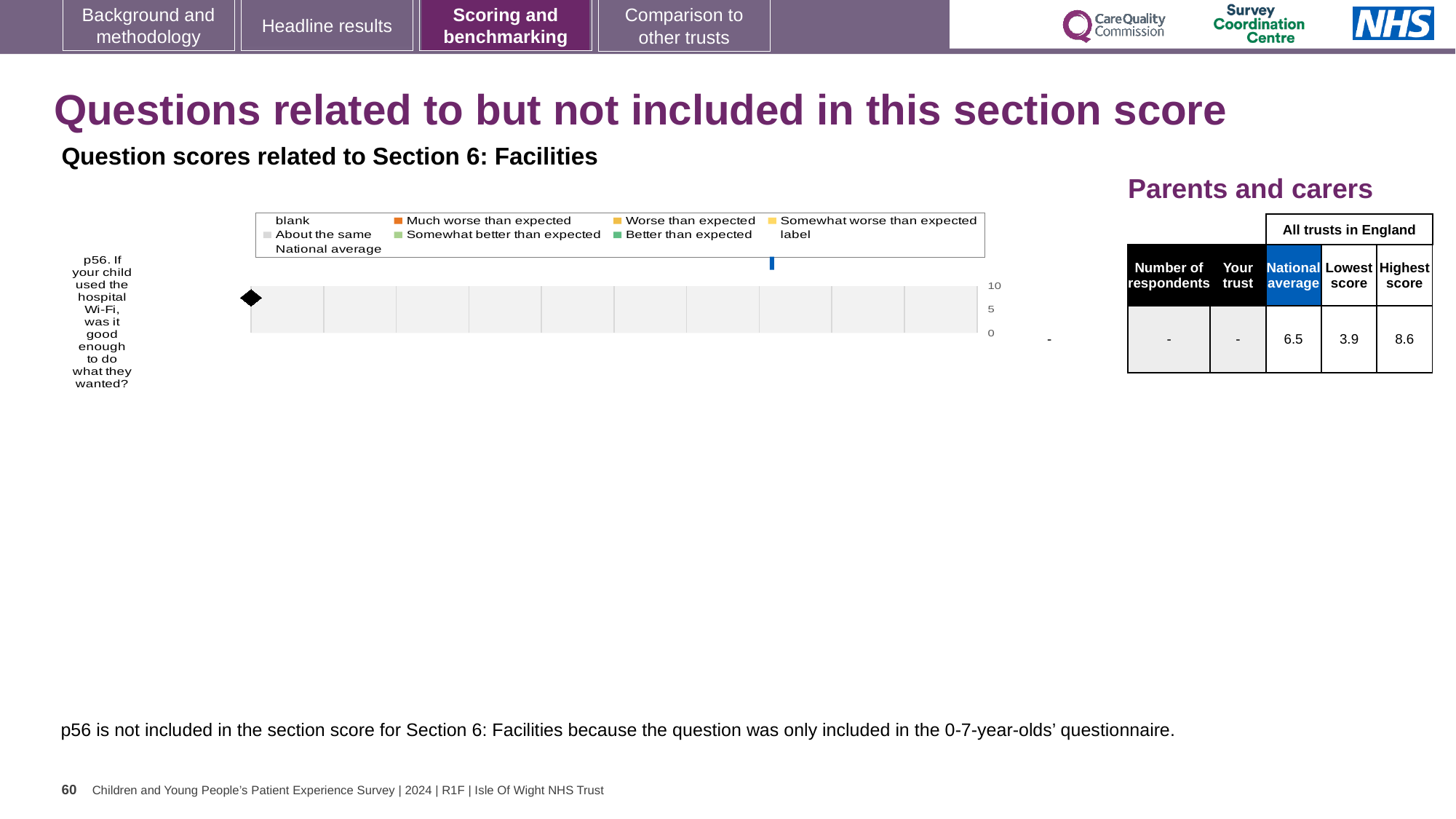
What is the highest value shown on the chart's score axis? 10 Which question is plotted on the chart? p56. If your child used the hospital Wi-Fi, was it good enough to do what they wanted? Is the national average for p56 greater or less than 5? greater What value is shown for 'Your trust' for p56? - What is the highest score among all trusts in England for p56? 8.6 What is the national average score for p56 shown in the Parents and carers table? 6.5 What is the lowest score among all trusts in England for p56? 3.9 How many survey questions are plotted on the chart? 1 What is the difference between the highest score and the lowest score for p56? 4.7 Which is larger for p56: the national average or the lowest score? national average What kind of chart is shown for the question scores related to Section 6: Facilities? bar chart